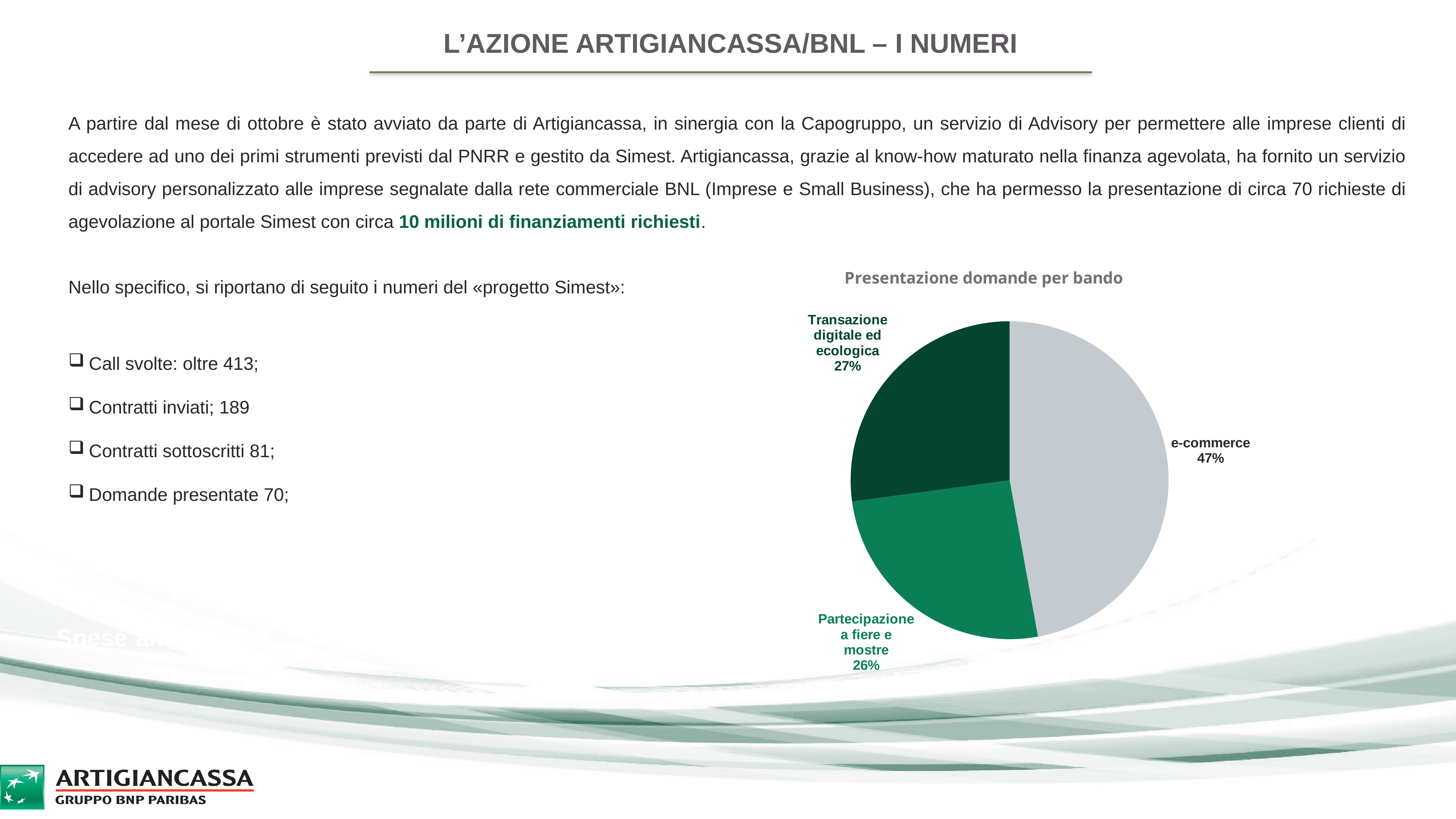
What percentage is shown for Partecipazione a fiere e mostre in the pie chart? 26% What kind of chart is shown on the slide? pie chart Which is larger in the pie chart: Transazione digitale ed ecologica or Partecipazione a fiere e mostre? Transazione digitale ed ecologica What is the title of the chart on the slide? Presentazione domande per bando By how many percentage points does e-commerce exceed Partecipazione a fiere e mostre in the pie chart? 21 What colour is the e-commerce slice in the pie chart? grey Which category has the largest slice in the pie chart? e-commerce By how many percentage points does e-commerce exceed Transazione digitale ed ecologica in the pie chart? 20 What percentage is shown for Transazione digitale ed ecologica in the pie chart? 27% How many slices does the pie chart have? 3 What share of the pie chart does e-commerce represent? 47% Which category has the smallest slice in the pie chart? Partecipazione a fiere e mostre